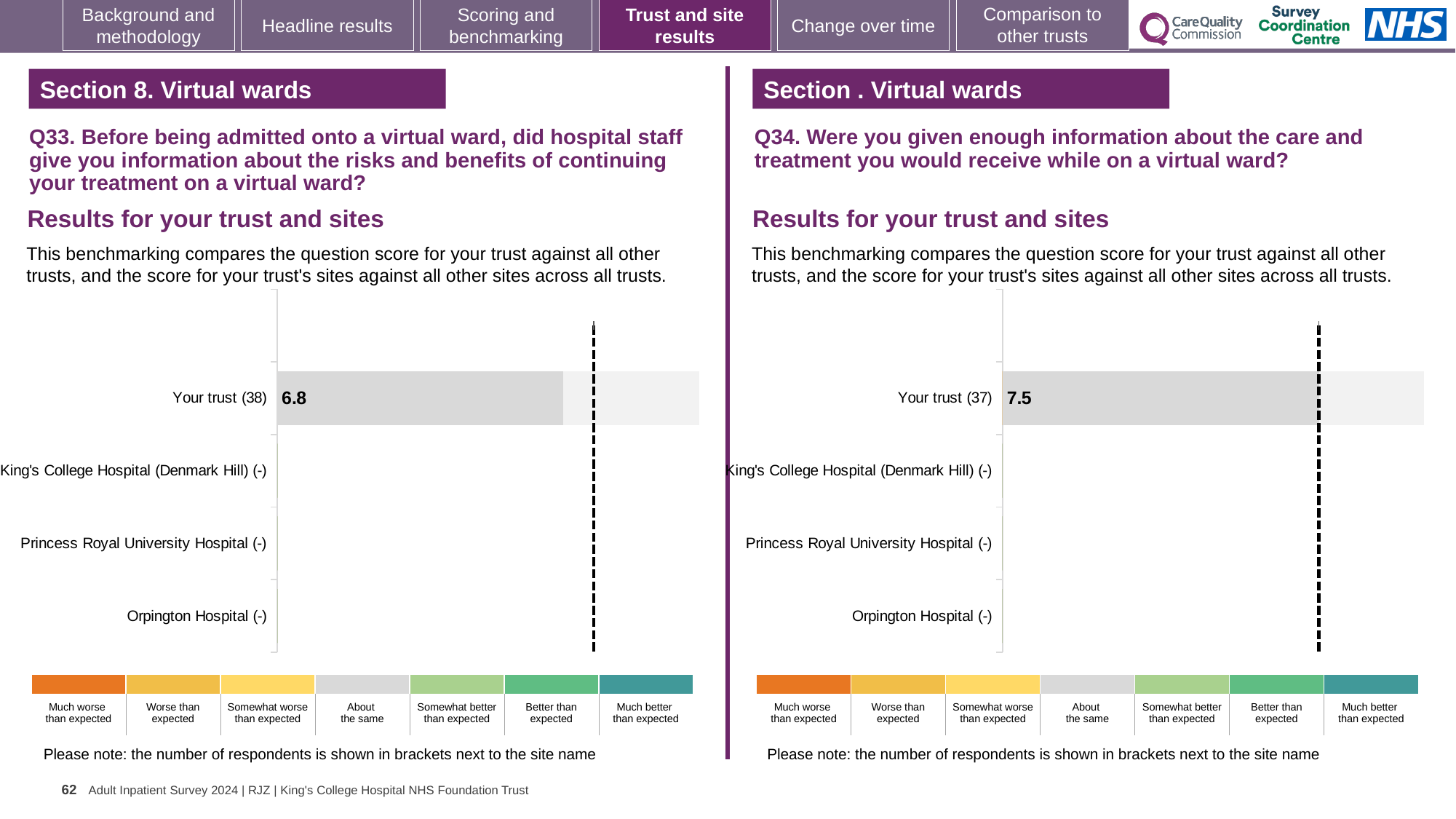
On the left chart (Q33), what is the score for Your trust? 6.8 On the left chart (Q33), how many respondents are shown in brackets next to Your trust? 38 On the left chart (Q33), which category has the only plotted bar? Your trust (38) What kind of chart is used on the left (Q33)? Bar chart On the right chart (Q34), how many respondents are shown in brackets next to Your trust? 37 How many colour categories does the legend below the right chart (Q34) show? 7 Which is larger: the Your trust score on the left chart (Q33) or the Your trust score on the right chart (Q34)? Q34 (7.5) On the right chart (Q34), what is the score for Your trust? 7.5 How many categories (rows) are listed on the left chart (Q33)? 4 How many categories (rows) are listed on the right chart (Q34)? 4 What is the difference between the Your trust score on the right chart (Q34) and the Your trust score on the left chart (Q33)? 0.7